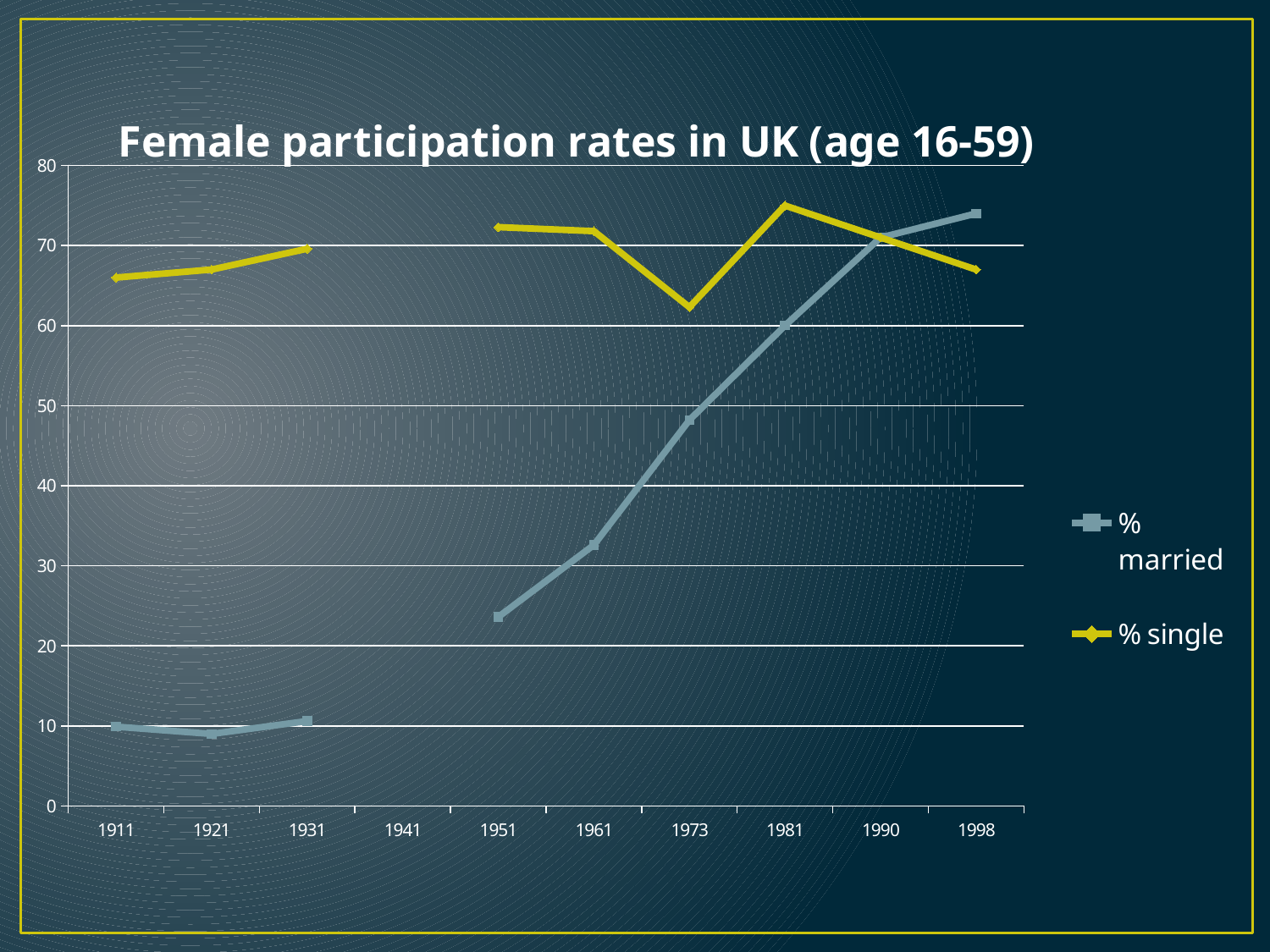
In 1998, which series has the larger value, % married or % single? % married In 1951, which series has the larger value, % married or % single? % single How many series does the legend list? 2 Does the % married line rise or fall from 1951 to 1998? rise How many years are labelled on the x axis? 10 Is the value for % single in 1973 greater or less than 70? less Is the value for % married in 1998 greater or less than 70? greater Is the value for % married in 1951 greater or less than 30? less What kind of chart is shown on the slide? line chart In which year does % single reach its highest value? 1981 In which year is % married at its lowest value? 1921